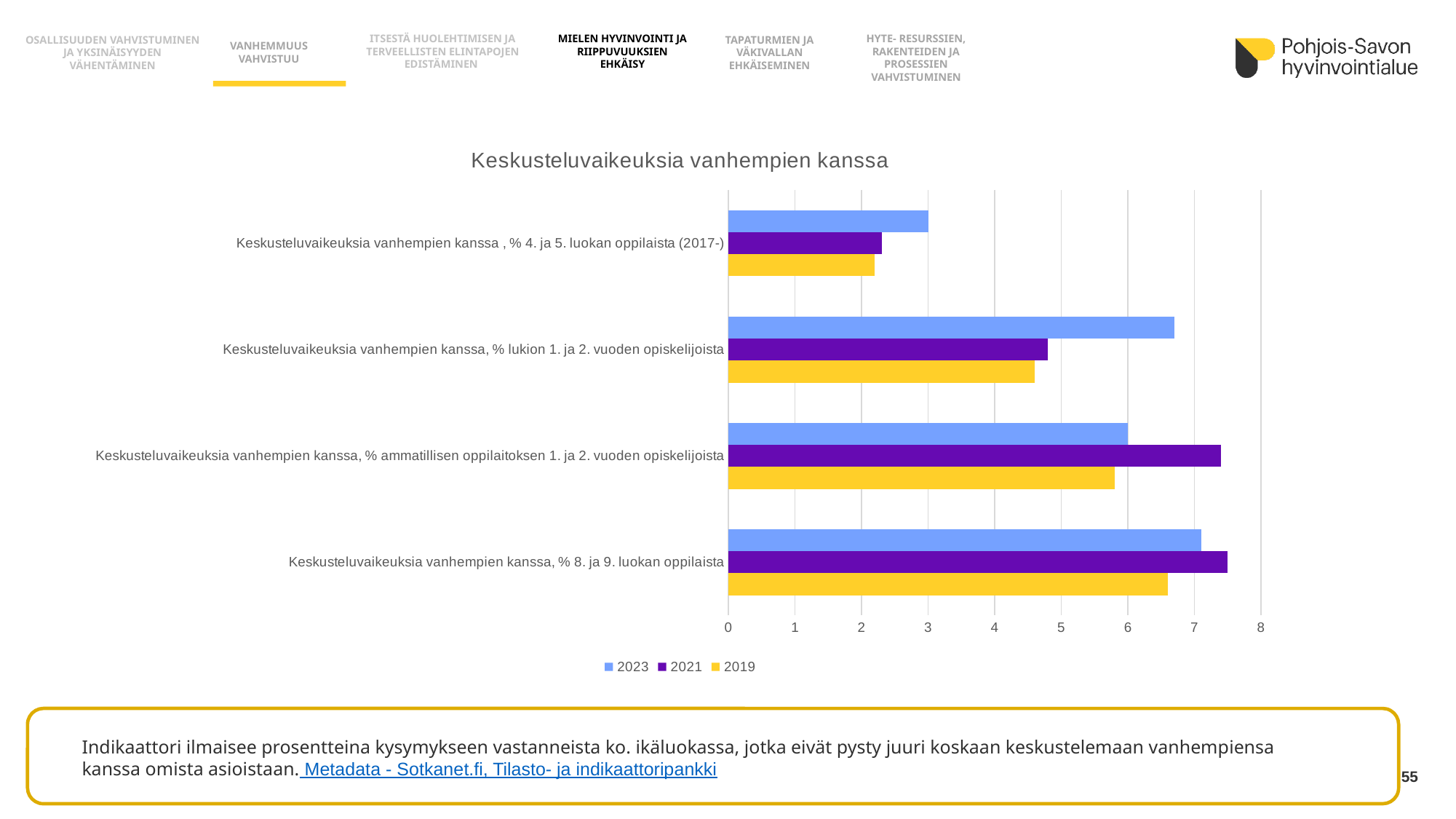
Which category has the lowest value for 2023? Keskusteluvaikeuksia vanhempien kanssa , % 4. ja 5. luokan oppilaista (2017-) For lukion 1. ja 2. vuoden opiskelijoista, which is larger: the 2023 value or the 2021 value? 2023 How many categories are shown on the chart? 4 Is the 2019 value for lukion 1. ja 2. vuoden opiskelijoista greater or less than 5? less Is the 2023 value for lukion 1. ja 2. vuoden opiskelijoista greater or less than 6? greater What is the title of the chart? Keskusteluvaikeuksia vanhempien kanssa Is the 2021 value for ammatillisen oppilaitoksen 1. ja 2. vuoden opiskelijoista greater or less than 7? greater Which years are listed in the legend? 2023, 2021, 2019 Which category has the lowest value for 2019? Keskusteluvaikeuksia vanhempien kanssa , % 4. ja 5. luokan oppilaista (2017-) How many series does the legend list? 3 What kind of chart is shown on the slide? bar chart For ammatillisen oppilaitoksen 1. ja 2. vuoden opiskelijoista, which is larger: the 2021 value or the 2019 value? 2021